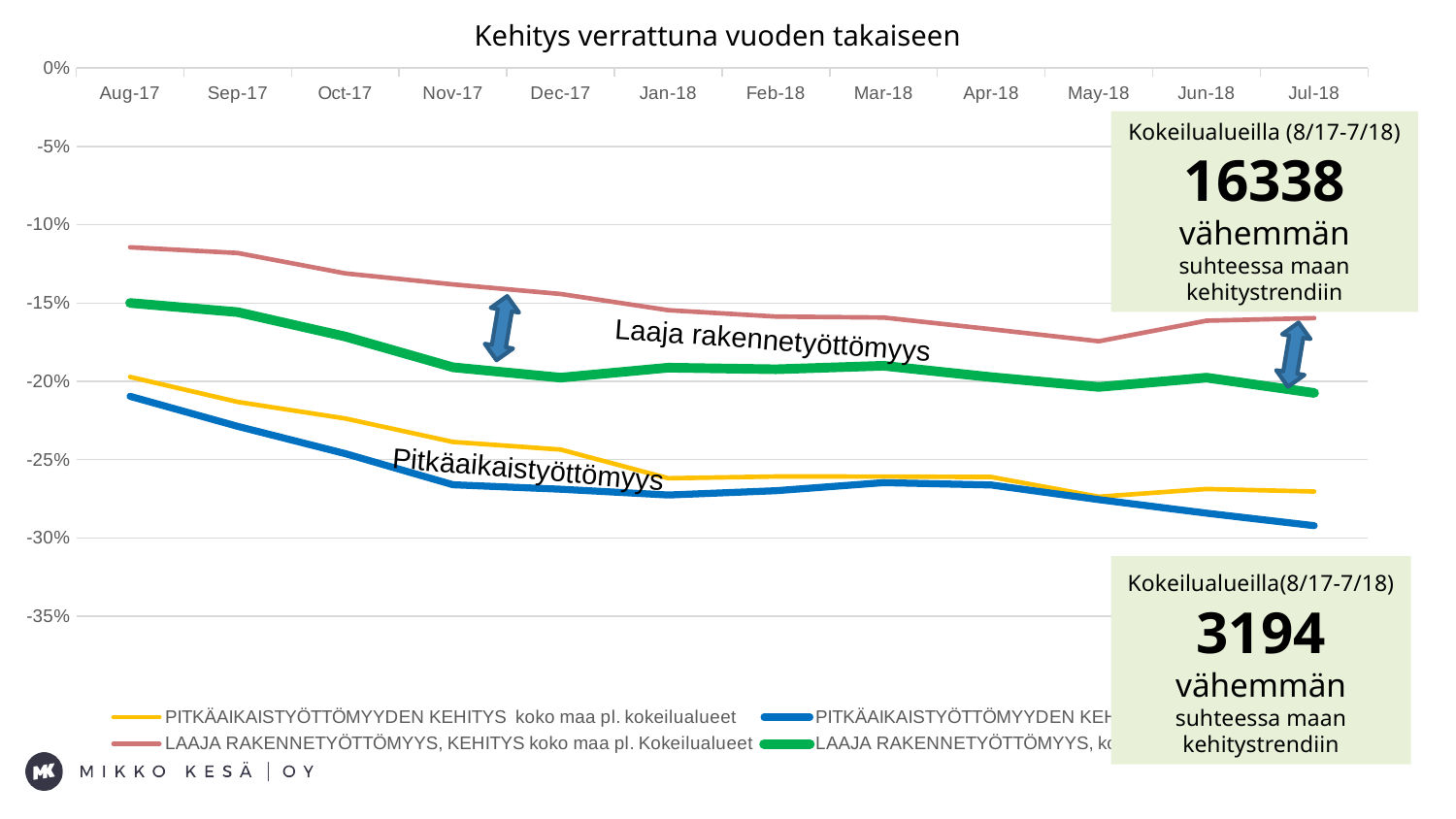
At Jul-18, which line has the lowest value in the chart? the blue line (Pitkäaikaistyöttömyys) Which month is the first point on the x axis? Aug-17 Is the value of the green line (Laaja rakennetyöttömyys) at Jul-18 greater or less than -15%? less Which month is the last point on the x axis? Jul-18 Do the lines in the chart generally rise or fall from Aug-17 to Jul-18? fall At Aug-17, which is higher: the red line or the green line? the red line Is the value of the blue line (Pitkäaikaistyöttömyys) at Jul-18 greater or less than -35%? greater What kind of chart is shown on the slide? line chart What is the title of the chart? Kehitys verrattuna vuoden takaiseen Is the value of the red line (LAAJA RAKENNETYÖTTÖMYYS, KEHITYS koko maa pl. Kokeilualueet) at Aug-17 greater or less than -10%? less How many months are shown along the x axis of the chart? 12 How many series does the chart's legend list? 4